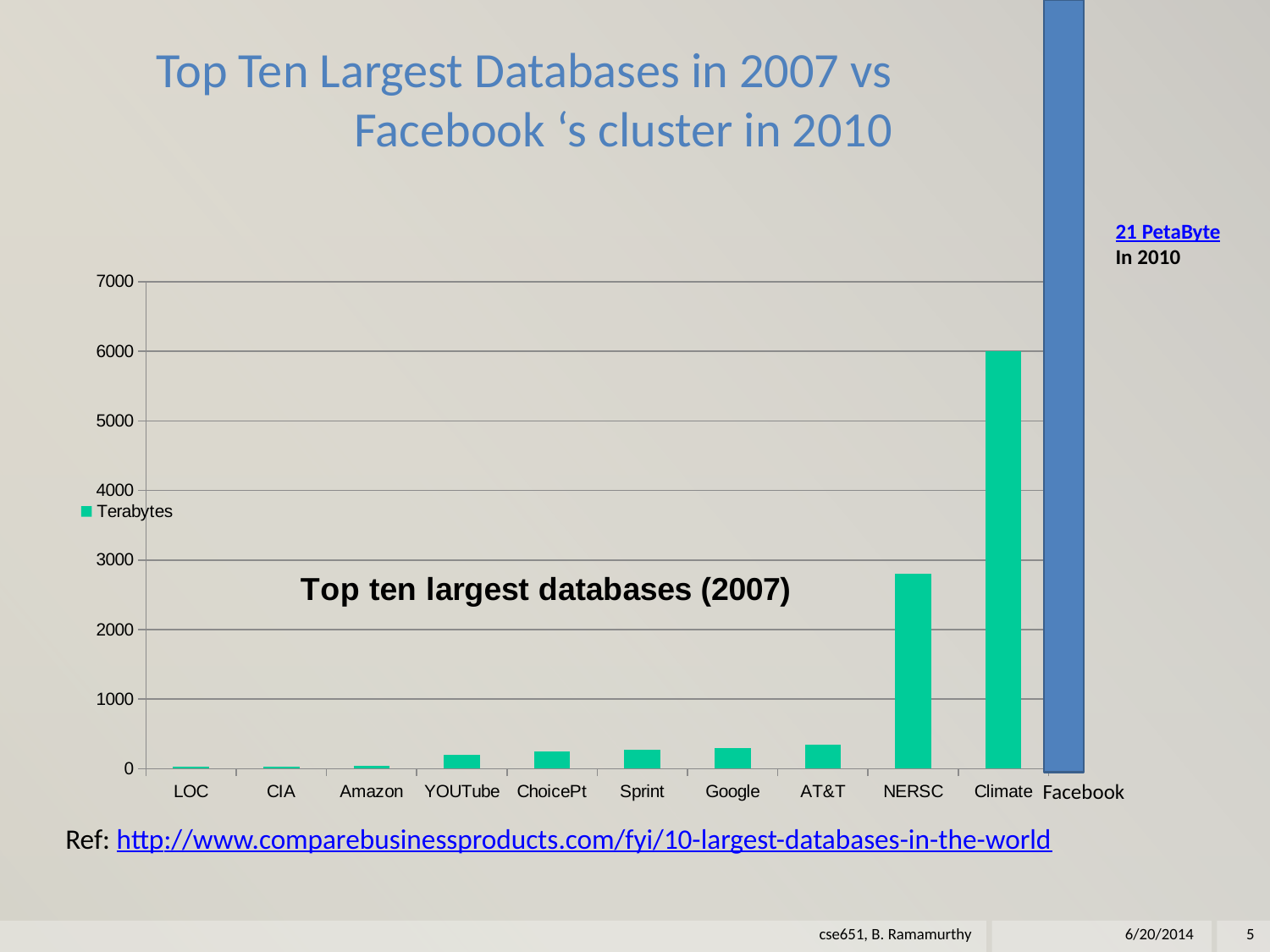
What kind of chart is shown on the slide? bar chart Which is larger, the value for Climate or the value for NERSC? Climate Excluding the Facebook bar, how many databases are plotted in the chart? 10 What value is given on the slide for Facebook's cluster in 2010? 21 PetaByte What is the legend entry for the plotted series? Terabytes Which is larger, the value for NERSC or the value for AT&T? NERSC Is the value for Google greater or less than 1000? less Is the value for Climate greater or less than 5000? greater Among the 2007 databases, which one has the tallest bar? Climate What title is printed inside the chart area? Top ten largest databases (2007) How many series does the chart's legend list? 1 Is the value for NERSC greater or less than 2000? greater